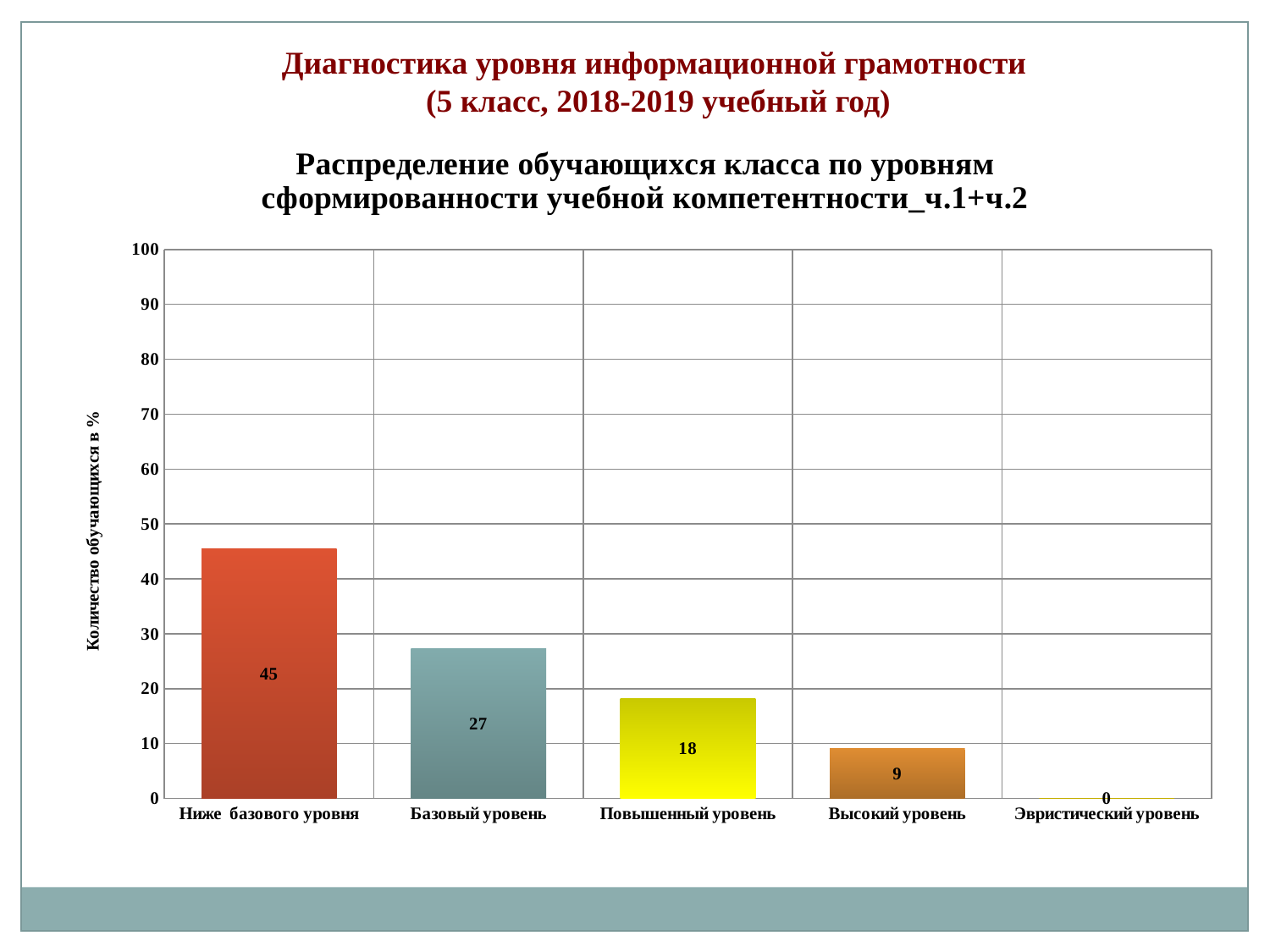
What is the value for Ниже базового уровня? 45 What kind of chart is shown on the slide? Bar chart Which category has the highest value? Ниже базового уровня What is the value for Эвристический уровень? 0 Do the values rise or fall from left to right along the x axis? Fall What is the value for Высокий уровень? 9 Which category has the lowest value? Эвристический уровень Which is larger, the value for Повышенный уровень or the value for Высокий уровень? Повышенный уровень What is the value for Повышенный уровень? 18 What is the difference between the values for Ниже базового уровня and Базовый уровень? 18 What is the value for Базовый уровень? 27 How many categories are shown on the x axis? 5